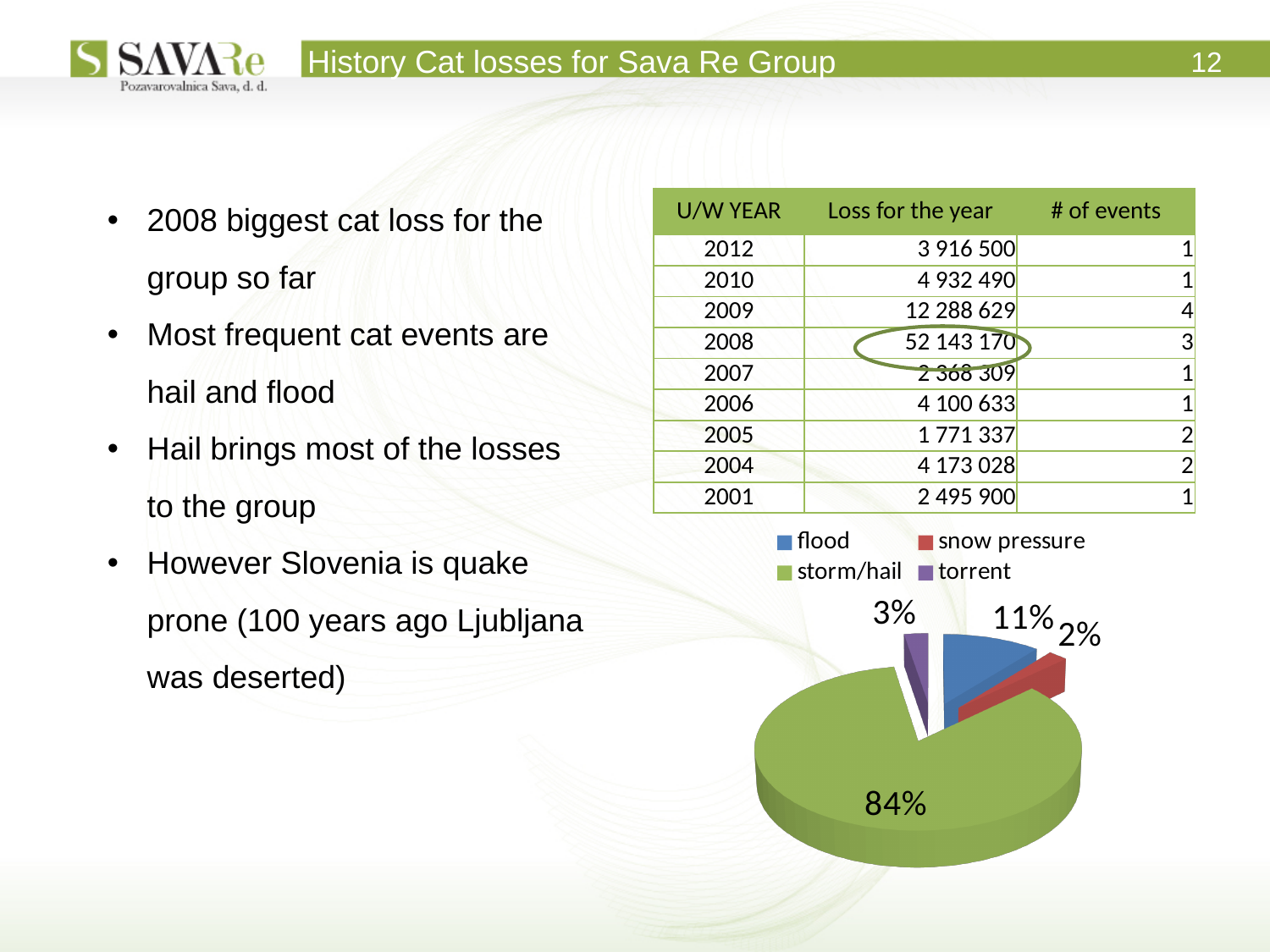
How many categories does the pie chart's legend list? 4 Which category has the largest slice of the pie? storm/hail Which category has the smallest slice of the pie? snow pressure What is the difference in percentage points between the storm/hail slice and the flood slice? 73 What share of the pie does storm/hail account for? 84% What share of the pie does flood account for? 11% Which is larger in the pie chart, flood or torrent? flood What share of the pie does snow pressure account for? 2% Which colour represents storm/hail in the pie chart? green Which category is shown in blue in the pie chart? flood What kind of chart is shown on the slide? pie chart